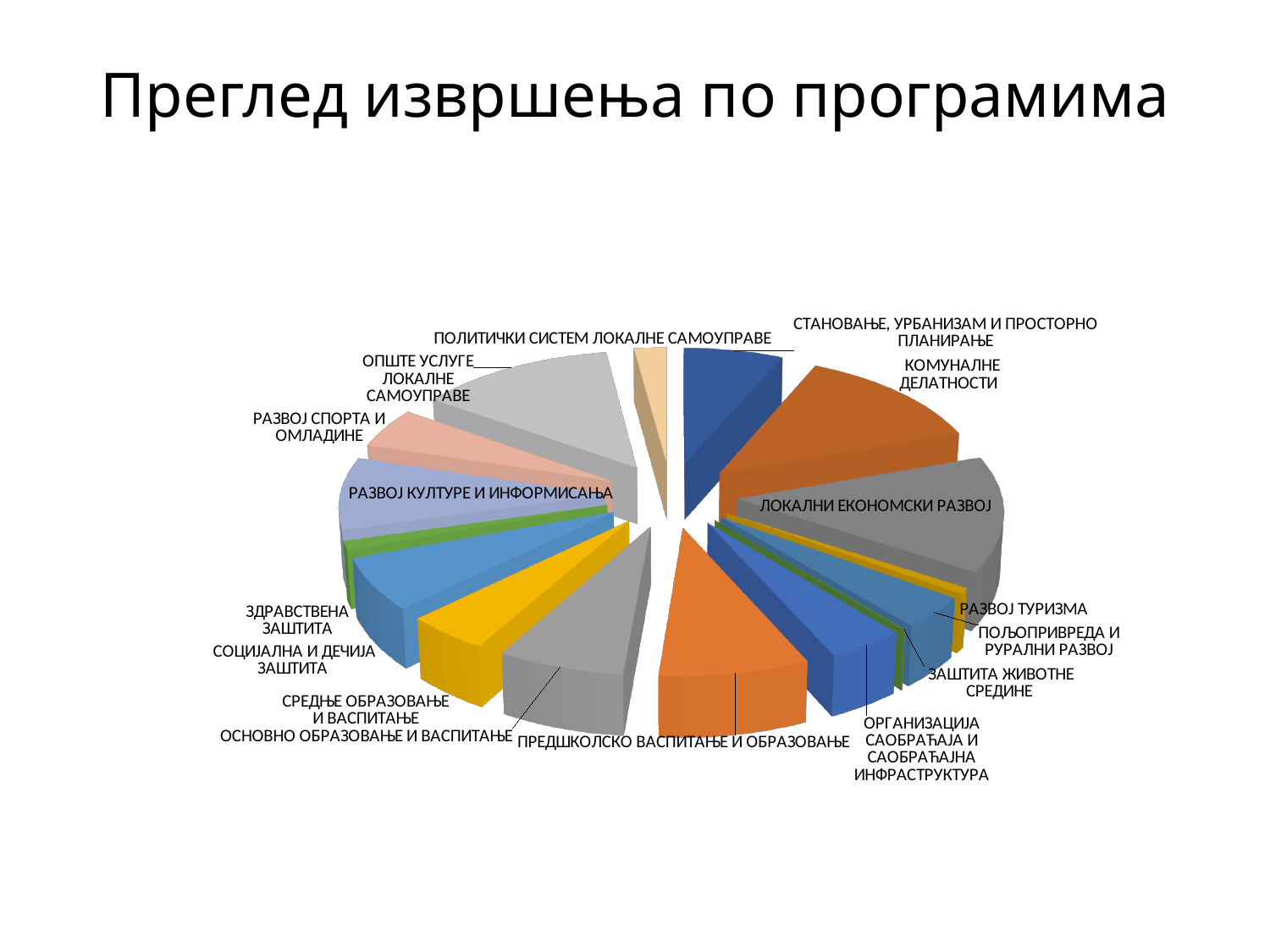
Which slice is larger: ПРЕДШКОЛСКО ВАСПИТАЊЕ И ОБРАЗОВАЊЕ or ЗДРАВСТВЕНА ЗАШТИТА? ПРЕДШКОЛСКО ВАСПИТАЊЕ И ОБРАЗОВАЊЕ Which slice is larger: РАЗВОЈ КУЛТУРЕ И ИНФОРМИСАЊА or РАЗВОЈ СПОРТА И ОМЛАДИНЕ? РАЗВОЈ КУЛТУРЕ И ИНФОРМИСАЊА Which program has the largest slice in the pie chart? ЛОКАЛНИ ЕКОНОМСКИ РАЗВОЈ Does the pie chart display numeric data labels on its slices? No What kind of chart is shown on the slide? pie chart Which slice is larger: ОСНОВНО ОБРАЗОВАЊЕ И ВАСПИТАЊЕ or ЗАШТИТА ЖИВОТНЕ СРЕДИНЕ? ОСНОВНО ОБРАЗОВАЊЕ И ВАСПИТАЊЕ How many slices (programs) does the pie chart have? 16 What is the title of the slide containing the pie chart? Преглед извршења по програмима